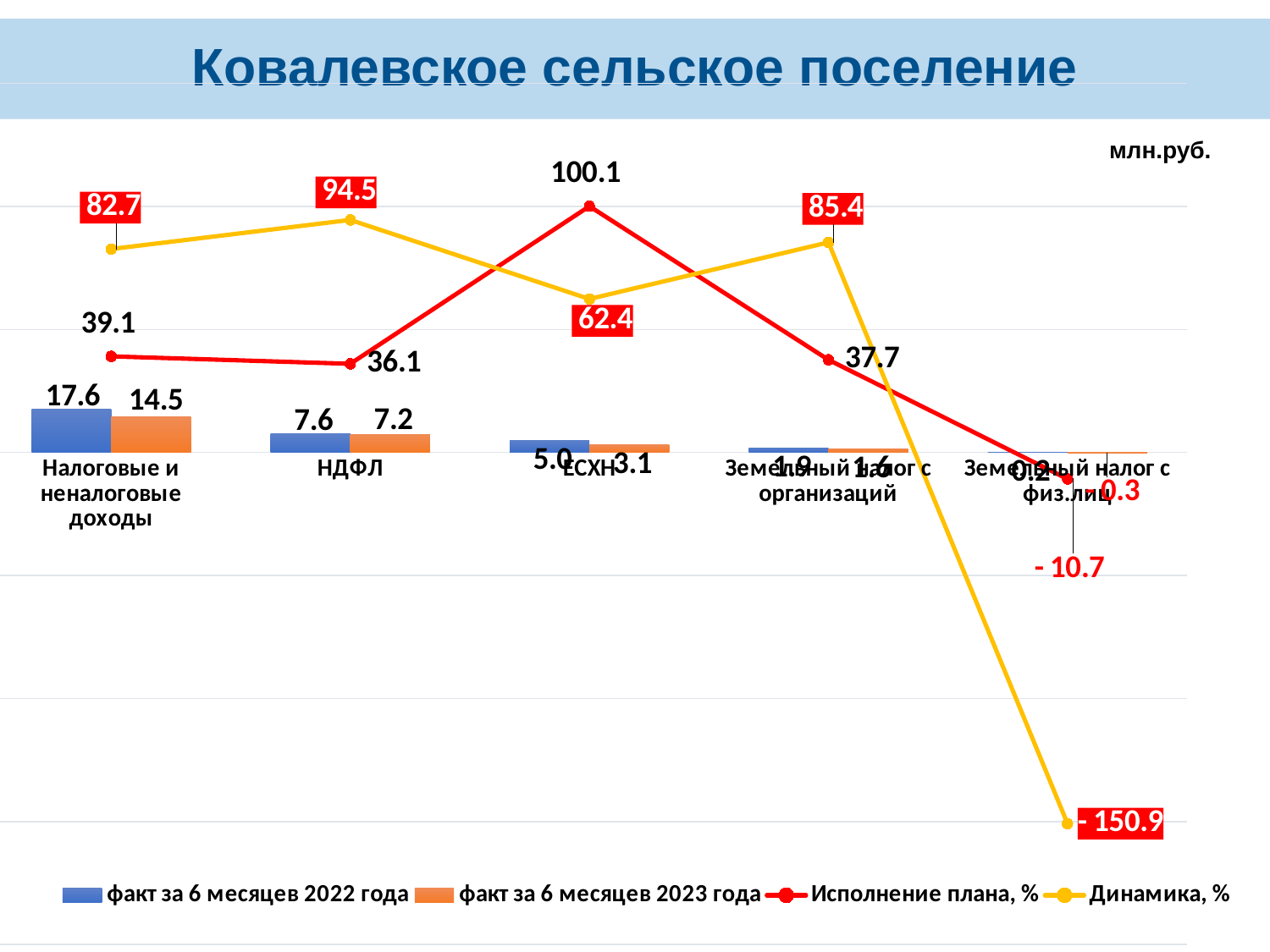
What is the value of 'факт за 6 месяцев 2023 года' for 'НДФЛ'? 7.2 How many categories are shown on the x axis? 5 What is the 'Динамика, %' value for 'Земельный налог с физ.лиц'? - 150.9 Which is larger for 'ЕСХН': the 'Исполнение плана, %' value or the 'Динамика, %' value? Исполнение плана, % Which category has the lowest 'Динамика, %' value? Земельный налог с физ.лиц What unit is indicated in the top right corner of the chart? млн.руб. What is the difference between the 2022 and 2023 fact values for 'Налоговые и неналоговые доходы'? 3.1 What is the value of 'факт за 6 месяцев 2022 года' for 'Налоговые и неналоговые доходы'? 17.6 Which category has the highest 'Исполнение плана, %' value? ЕСХН What is the 'Динамика, %' value for 'НДФЛ'? 94.5 What is the 'Исполнение плана, %' value for 'ЕСХН'? 100.1 How many series does the legend list? 4